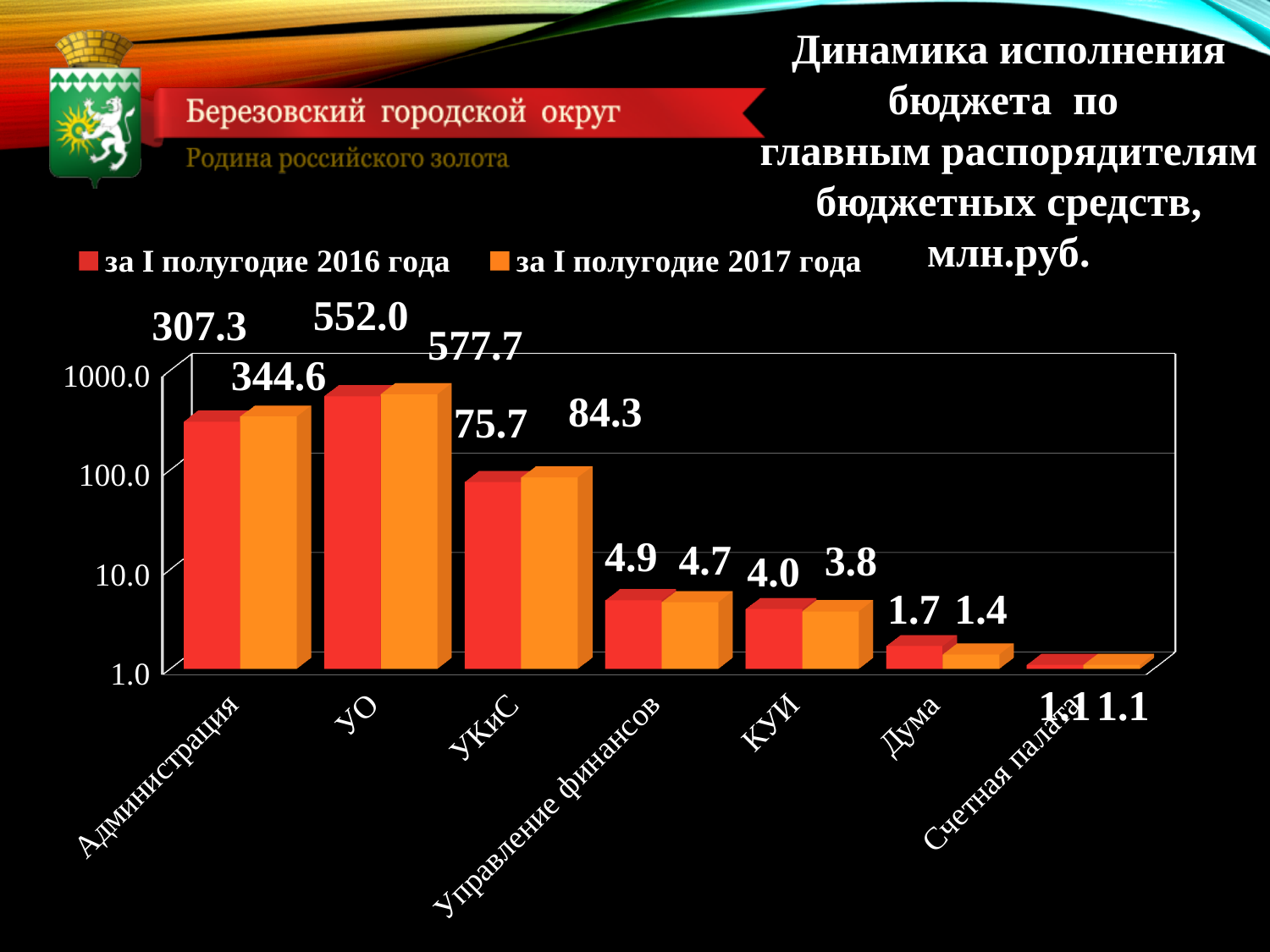
What is the value for Дума for за I полугодие 2017 года? 1.4 How many series does the legend list? 2 What is the value for УО for за I полугодие 2017 года? 577.7 Which is larger for КУИ: the value for за I полугодие 2016 года or за I полугодие 2017 года? за I полугодие 2016 года Which category has the lowest value for за I полугодие 2016 года? Счетная палата What is the difference between the за I полугодие 2017 года and за I полугодие 2016 года values for Администрация? 37.3 What is the value for Администрация for за I полугодие 2016 года? 307.3 How many categories are shown on the x axis? 7 What kind of chart is shown on the slide? bar chart What is the value for УКиС for за I полугодие 2016 года? 75.7 Which category has the highest value for за I полугодие 2017 года? УО What colour are the bars for за I полугодие 2017 года? orange